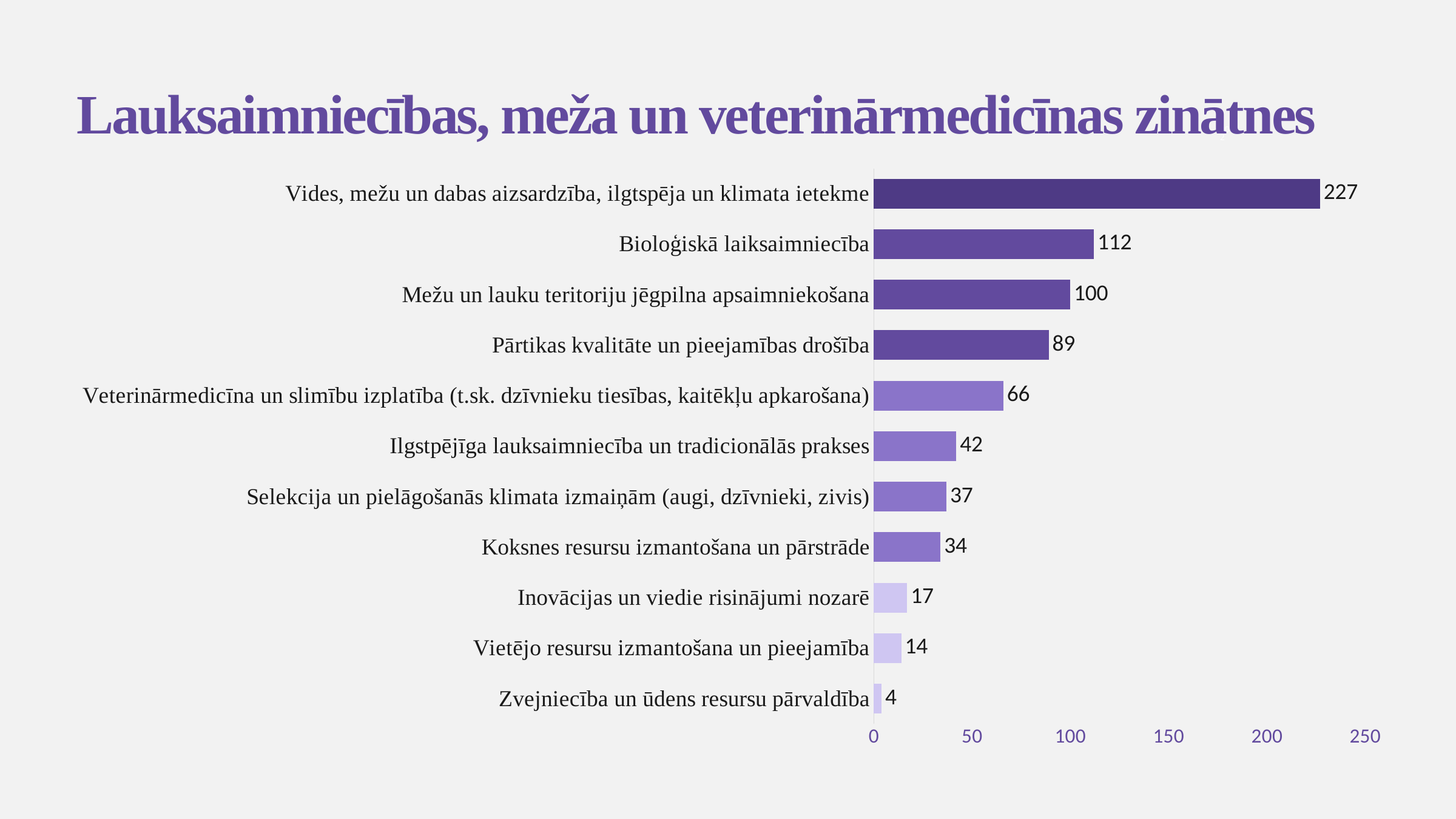
What is the difference between the values for Vides, mežu un dabas aizsardzība, ilgtspēja un klimata ietekme and Bioloģiskā laiksaimniecība? 115 Which category has the highest value? Vides, mežu un dabas aizsardzība, ilgtspēja un klimata ietekme Which is larger: the value for Inovācijas un viedie risinājumi nozarē or the value for Vietējo resursu izmantošana un pieejamība? Inovācijas un viedie risinājumi nozarē What is the value for Koksnes resursu izmantošana un pārstrāde? 34 What kind of chart is shown on the slide? Bar chart Is the value for Veterinārmedicīna un slimību izplatība (t.sk. dzīvnieku tiesības, kaitēkļu apkarošana) greater or less than 50? greater What is the title of the slide? Lauksaimniecības, meža un veterinārmedicīnas zinātnes How many categories are shown in the chart? 11 Which category has the lowest value? Zvejniecība un ūdens resursu pārvaldība What is the difference between the values for Ilgstpējīga lauksaimniecība un tradicionālās prakses and Selekcija un pielāgošanās klimata izmaiņām (augi, dzīvnieki, zivis)? 5 What is the value for Bioloģiskā laiksaimniecība? 112 What is the value for Pārtikas kvalitāte un pieejamības drošība? 89